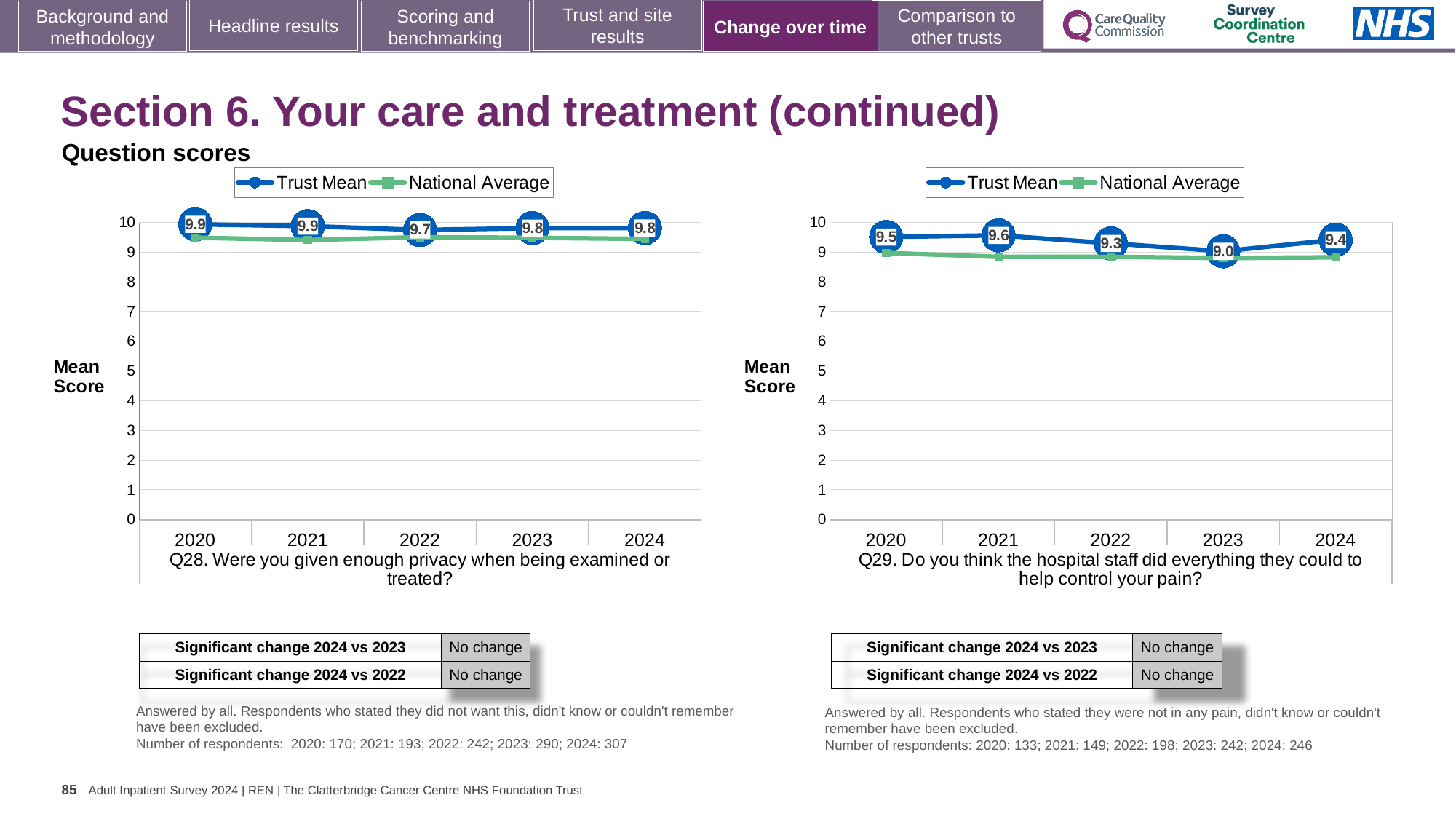
In the Q29 chart (right), what is the difference between the Trust Mean in 2021 and in 2023? 0.6 In the Q29 chart (right), which year has the highest Trust Mean? 2021 In the Q28 chart (left), what is the Trust Mean for 2022? 9.7 In the Q28 chart (left), which year has the lowest Trust Mean? 2022 How many series does the legend of the Q29 chart (right) list? 2 In the Q28 chart (left), is the Trust Mean higher in 2020 or in 2022? 2020 How many years are plotted on the x axis of the Q28 chart (left)? 5 In the Q29 chart (right), which year has the lowest Trust Mean? 2023 In the Q29 chart (right), what is the Trust Mean for 2023? 9.0 In the Q28 chart (left), what is the Trust Mean for 2020? 9.9 In the Q29 chart (right), what is the Trust Mean for 2024? 9.4 In the Q29 chart (right), is the National Average for 2024 greater or less than 8? greater